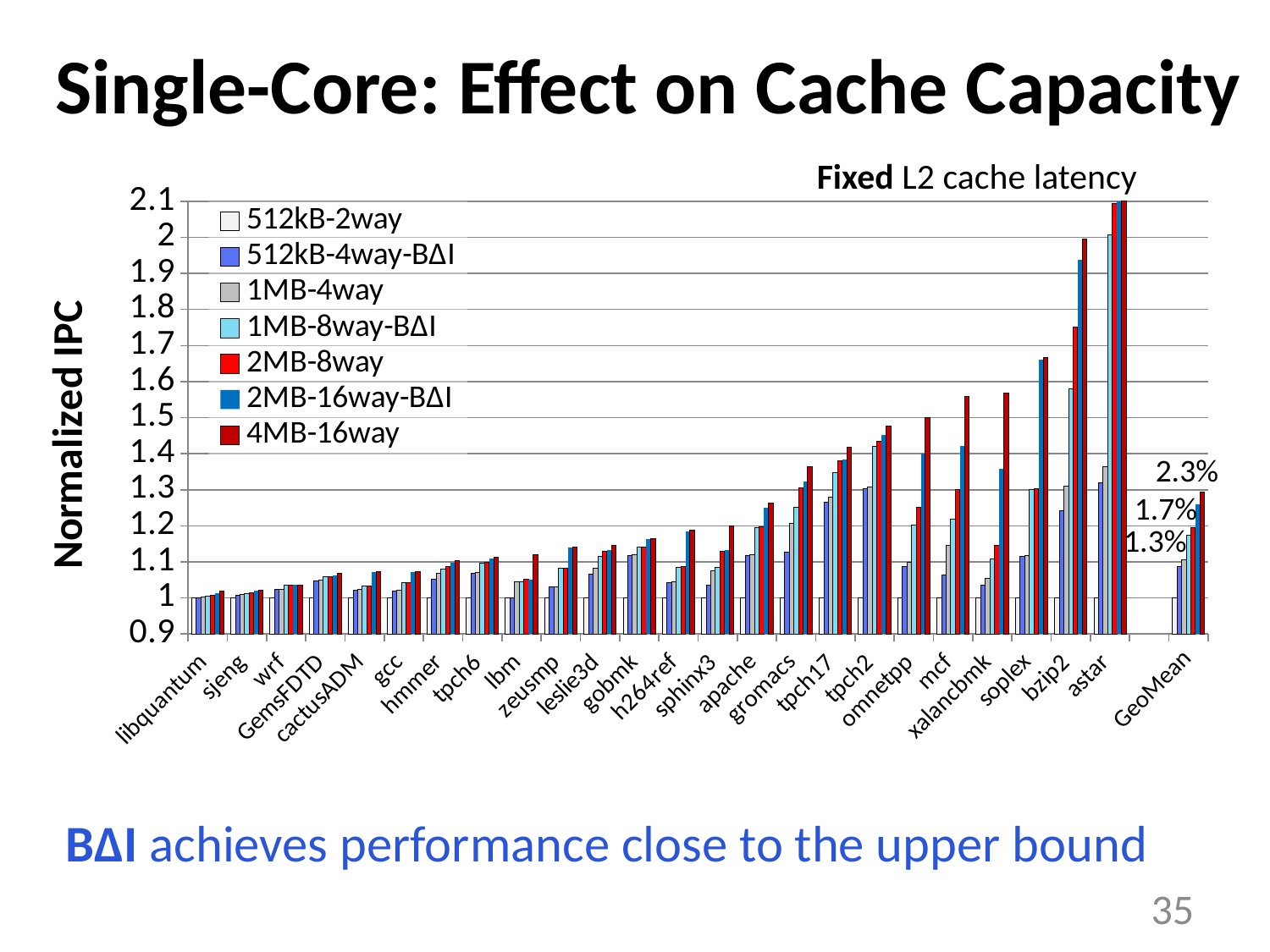
Which category has the lowest Normalized IPC values? libquantum What is the label of the y axis? Normalized IPC What kind of chart is shown on the slide? bar chart How many series does the legend list? 7 Do the Normalized IPC values generally rise or fall moving left to right across the benchmarks from libquantum to astar? rise How many categories are shown along the x axis? 25 Is the 4MB-16way value for libquantum greater or less than 1.1? less Which has the larger 4MB-16way value, soplex or gcc? soplex Is the 4MB-16way value for astar greater or less than 2? greater Which category has the highest Normalized IPC values? astar What percentage is annotated at the top of the GeoMean bars? 2.3% Is the 4MB-16way value for soplex greater or less than 1.6? greater